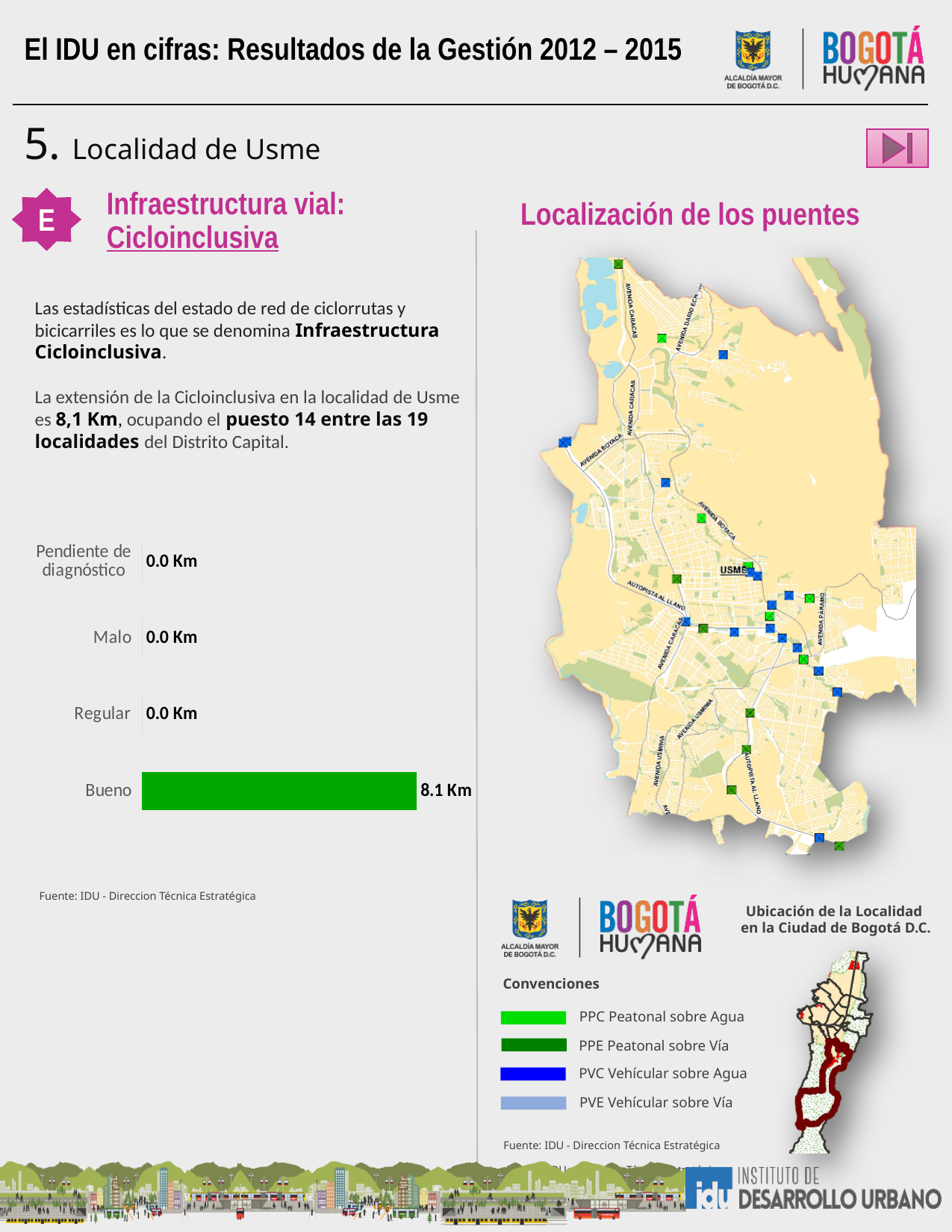
What kind of chart is shown on the left side of the slide? Bar chart Which is larger in the bar chart, the value for Bueno or the value for Malo? Bueno What is the total of all four categories in the bar chart? 8.1 Km What colour is the bar for Bueno in the bar chart? Green What is the value for Bueno in the bar chart? 8.1 Km What is the value for Regular in the bar chart? 0.0 Km How many categories in the bar chart have a value of 0.0 Km? 3 What is the value for Pendiente de diagnóstico in the bar chart? 0.0 Km How many categories are shown in the bar chart? 4 What is the value for Malo in the bar chart? 0.0 Km Which category has the highest value in the bar chart? Bueno What is the difference between the values for Bueno and Regular in the bar chart? 8.1 Km